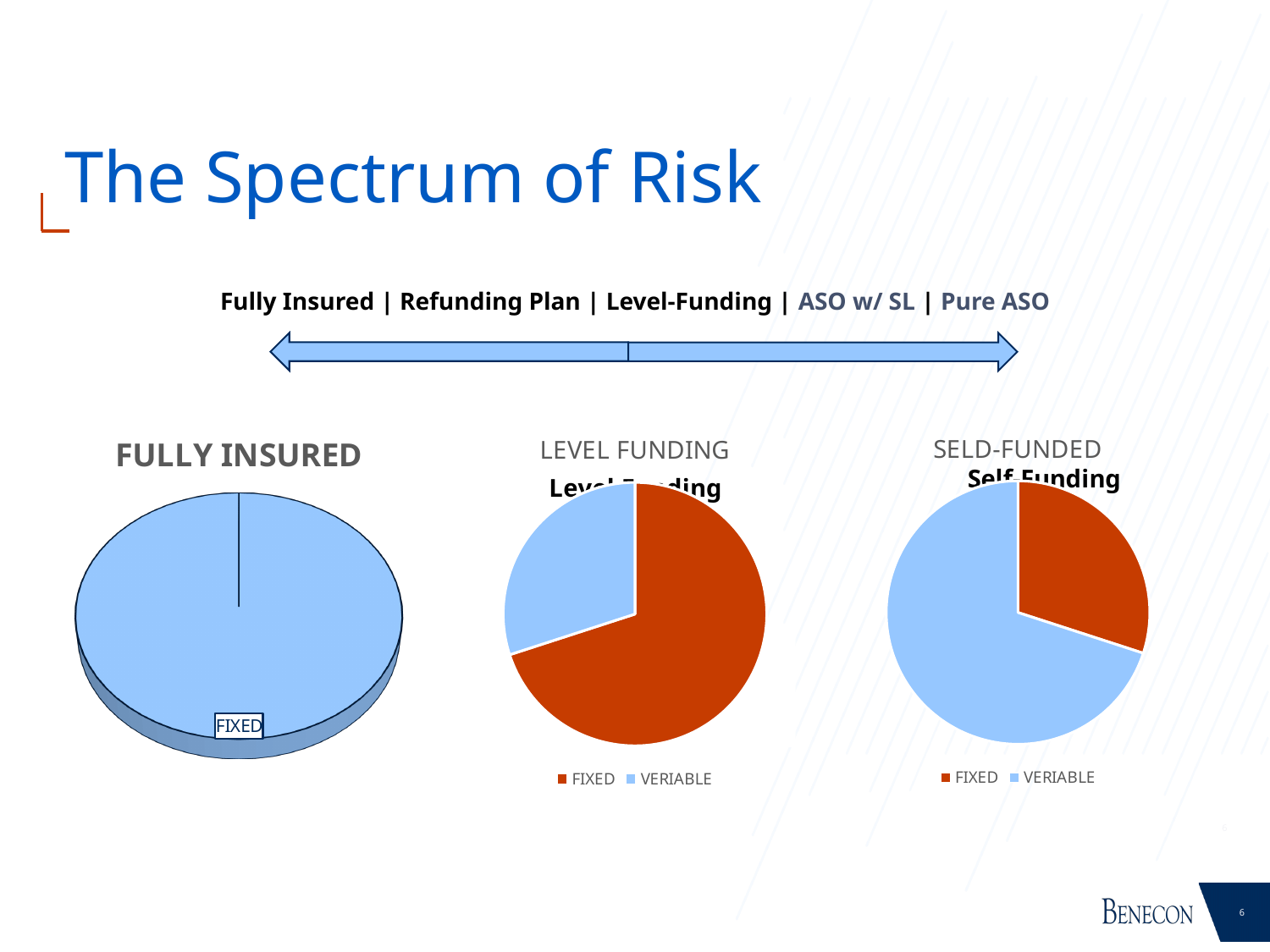
What kind of chart is the LEVEL FUNDING chart? pie chart What kind of chart is the FULLY INSURED chart? pie chart How many entries does the legend of the SELD-FUNDED chart list? 2 In the SELD-FUNDED pie chart, which slice is the largest? VERIABLE What colour represents FIXED in the legend of the SELD-FUNDED chart? orange-red How many slices does the FULLY INSURED pie chart have? 1 In the LEVEL FUNDING pie chart, which slice is the smallest? VERIABLE How many pie charts are shown on the slide? 3 In the LEVEL FUNDING pie chart, which slice is larger, FIXED or VERIABLE? FIXED In the SELD-FUNDED pie chart, which slice is larger, FIXED or VERIABLE? VERIABLE How many entries does the legend of the LEVEL FUNDING chart list? 2 What is the only slice labelled in the FULLY INSURED pie chart? FIXED